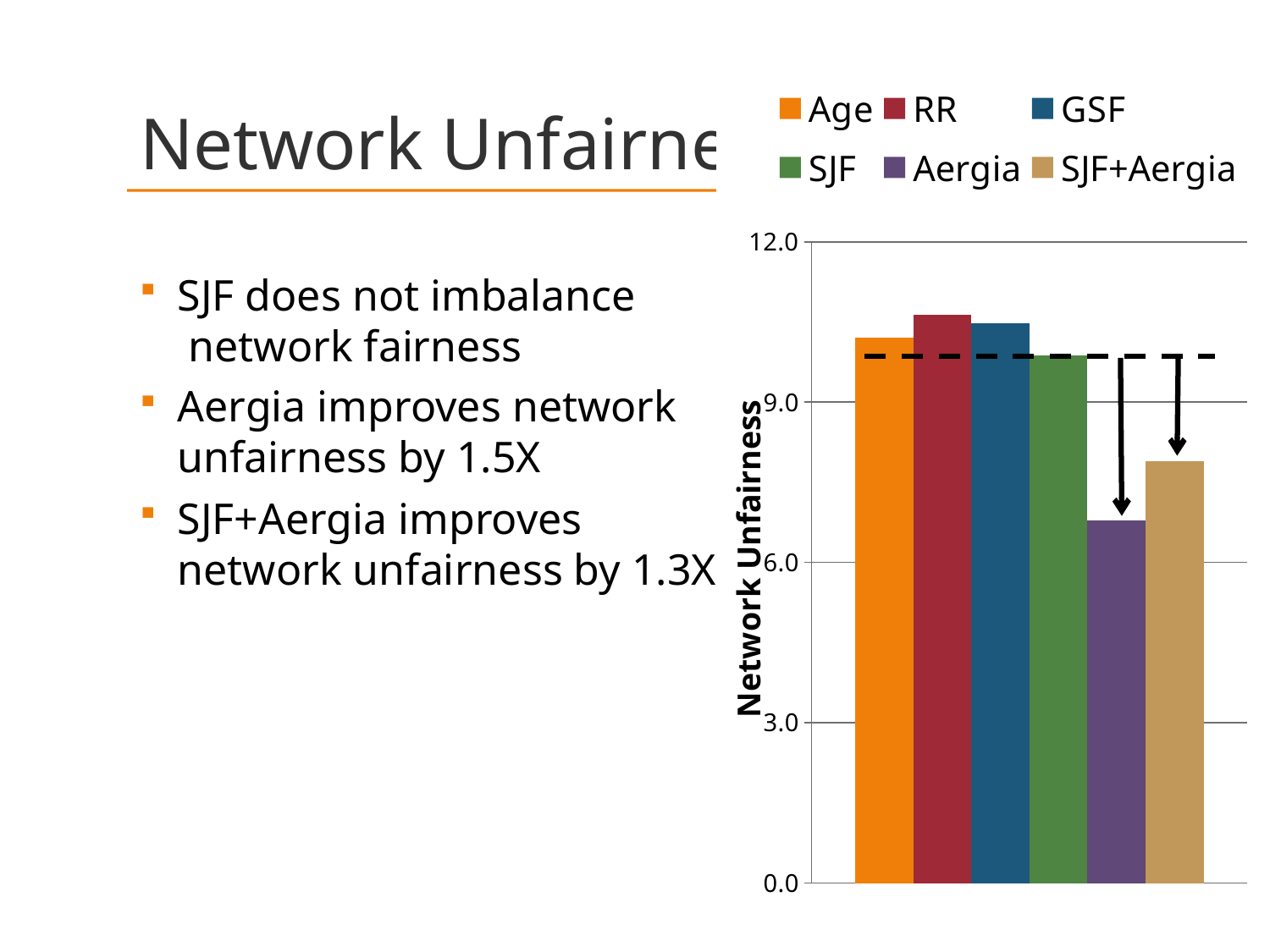
Which has the larger Network Unfairness value, Aergia or SJF+Aergia? SJF+Aergia Which has the larger Network Unfairness value, SJF or SJF+Aergia? SJF How many series does the chart's legend list? 6 Is the Network Unfairness value for Aergia greater or less than 9.0? less Which series is shown in purple in the chart's legend? Aergia What is the title of the chart's vertical axis? Network Unfairness Which has the larger Network Unfairness value, Age or Aergia? Age Which series has the lowest Network Unfairness value? Aergia Is the Network Unfairness value for RR greater or less than 9.0? greater What kind of chart is shown on the slide? bar chart Is the Network Unfairness value for Aergia greater or less than 6.0? greater